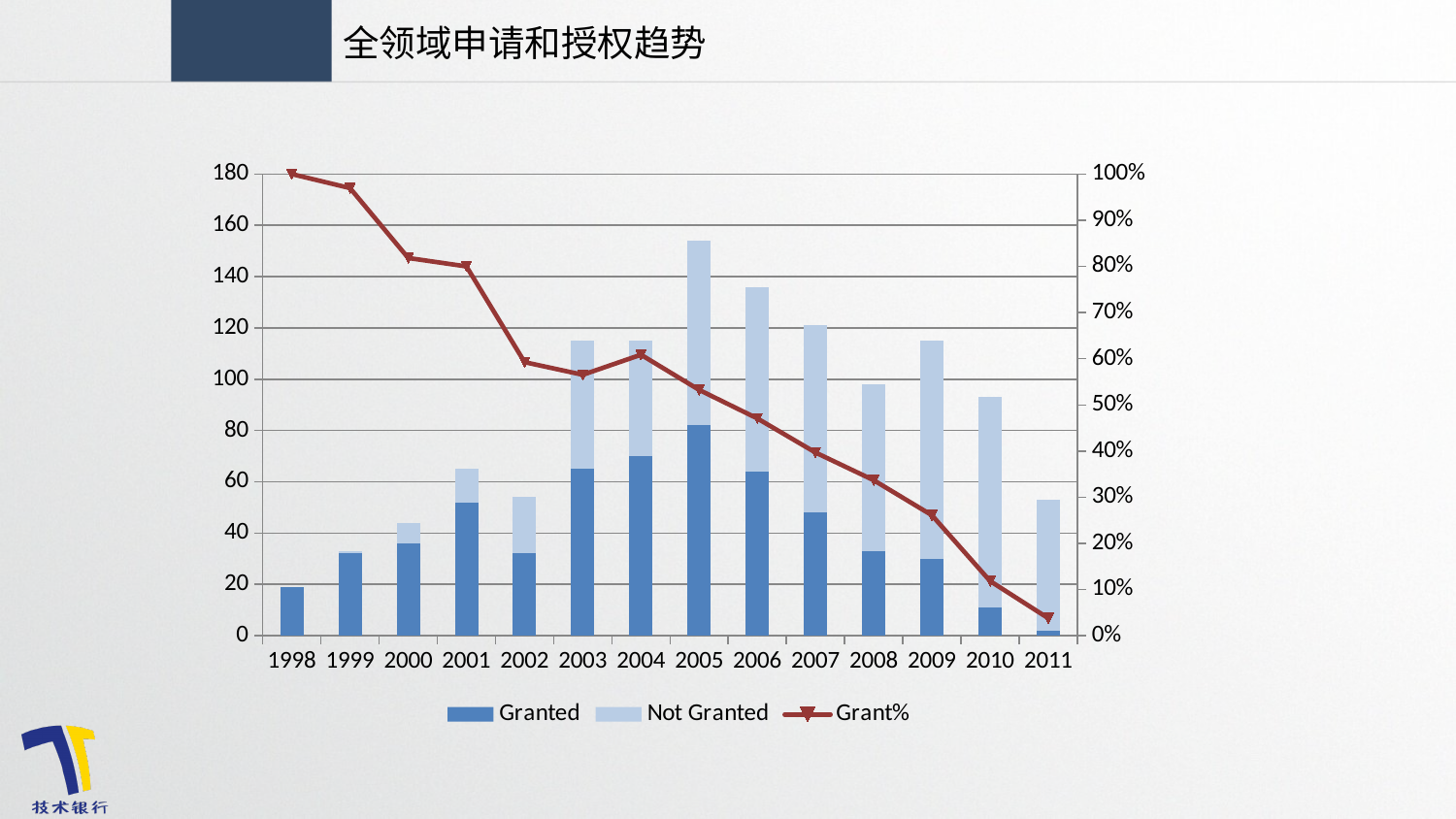
Is the Granted value for 2005 greater or less than 60? greater How many years are shown on the x axis of the chart? 14 Which year has the highest Granted value? 2005 What kind of chart is shown on the slide? A bar chart combined with a line Is the Grant% value for 2000 greater or less than 70%? greater Is the Grant% value for 2011 greater or less than 10%? less Which series is plotted as a line rather than bars? Grant% Which year has the lowest Granted value? 2011 Which year has the larger Granted value, 2004 or 2007? 2004 How many series does the chart's legend list? 3 Does the Grant% line generally rise or fall from 1998 to 2011? fall Which year has the tallest stacked bar (Granted plus Not Granted)? 2005